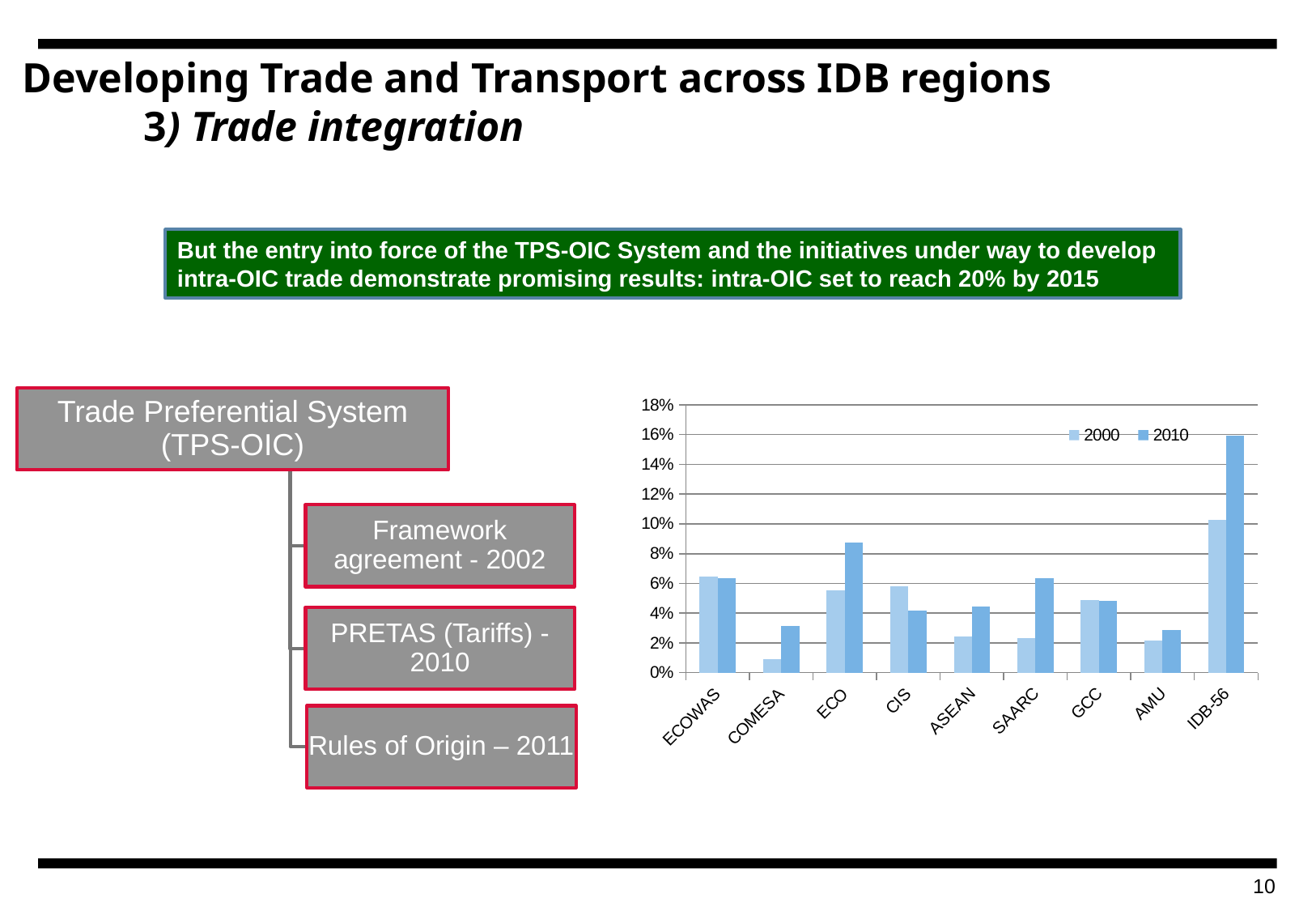
What kind of chart is shown on the slide? bar chart For SAARC, which series has the larger value, 2000 or 2010? 2010 Which category has the lowest value for the 2000 series? COMESA Is the 2010 value for ECO greater or less than 8%? greater Is the 2000 value for COMESA greater or less than 2%? less What are the two series named in the chart's legend? 2000 and 2010 Which category has the highest value for the 2000 series? IDB-56 How many series does the chart's legend list? 2 How many categories are shown along the x axis of the chart? 9 Is the 2010 value for IDB-56 greater or less than 14%? greater Which category has the highest value for the 2010 series? IDB-56 For CIS, which series has the larger value, 2000 or 2010? 2000